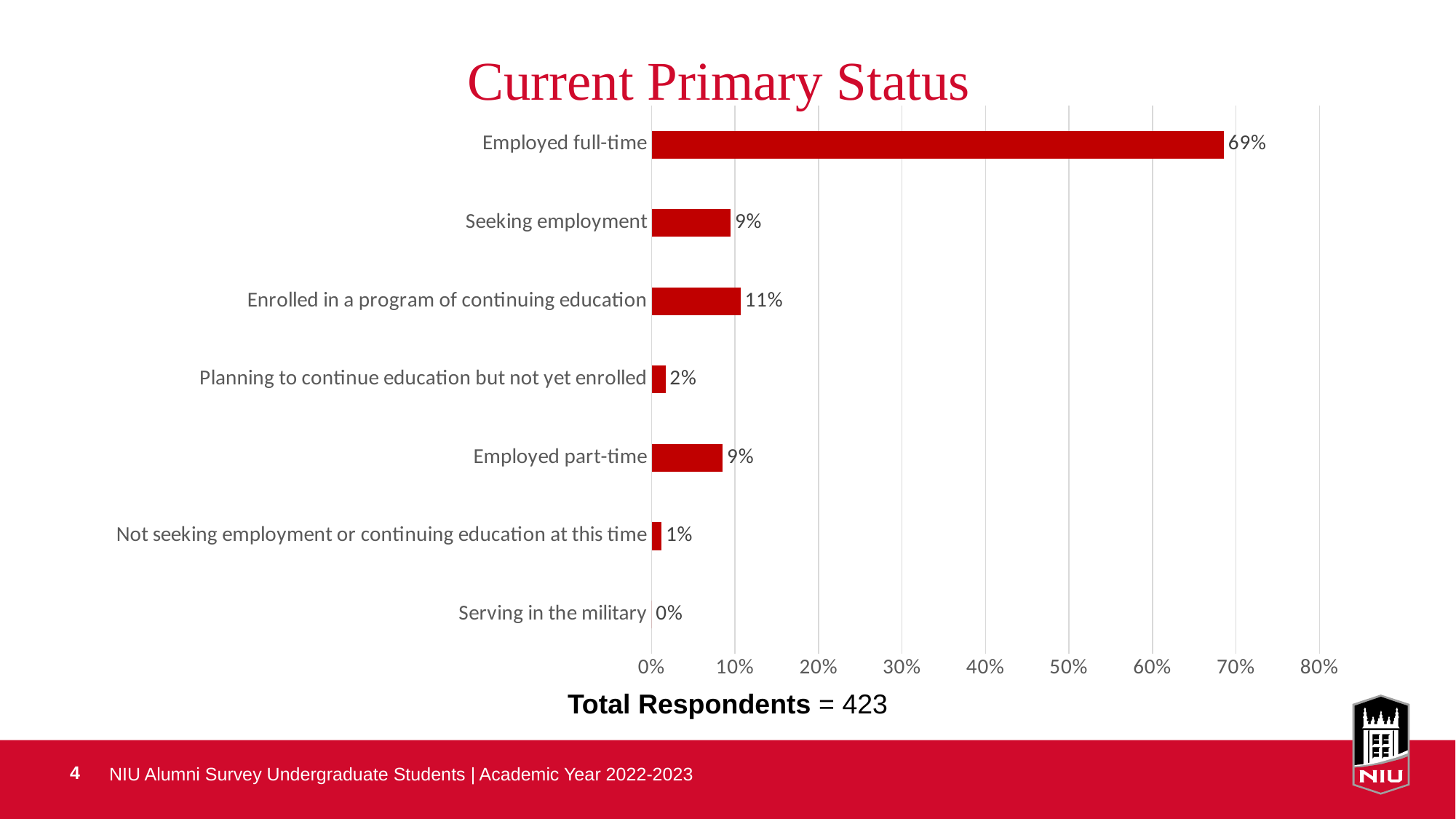
What percentage of respondents are planning to continue education but not yet enrolled? 2% Which category has the lowest value? Serving in the military What is the title of the chart? Current Primary Status What is the value for 'Serving in the military'? 0% What kind of chart is shown on the slide? Bar chart What percentage of respondents are employed full-time? 69% What is the value for 'Enrolled in a program of continuing education'? 11% Which is larger: 'Enrolled in a program of continuing education' or 'Seeking employment'? Enrolled in a program of continuing education Which category has the highest value? Employed full-time Is the value for 'Employed full-time' greater or less than 60%? greater How many categories are shown in the chart? 7 What is the difference between 'Employed full-time' and 'Enrolled in a program of continuing education'? 58%